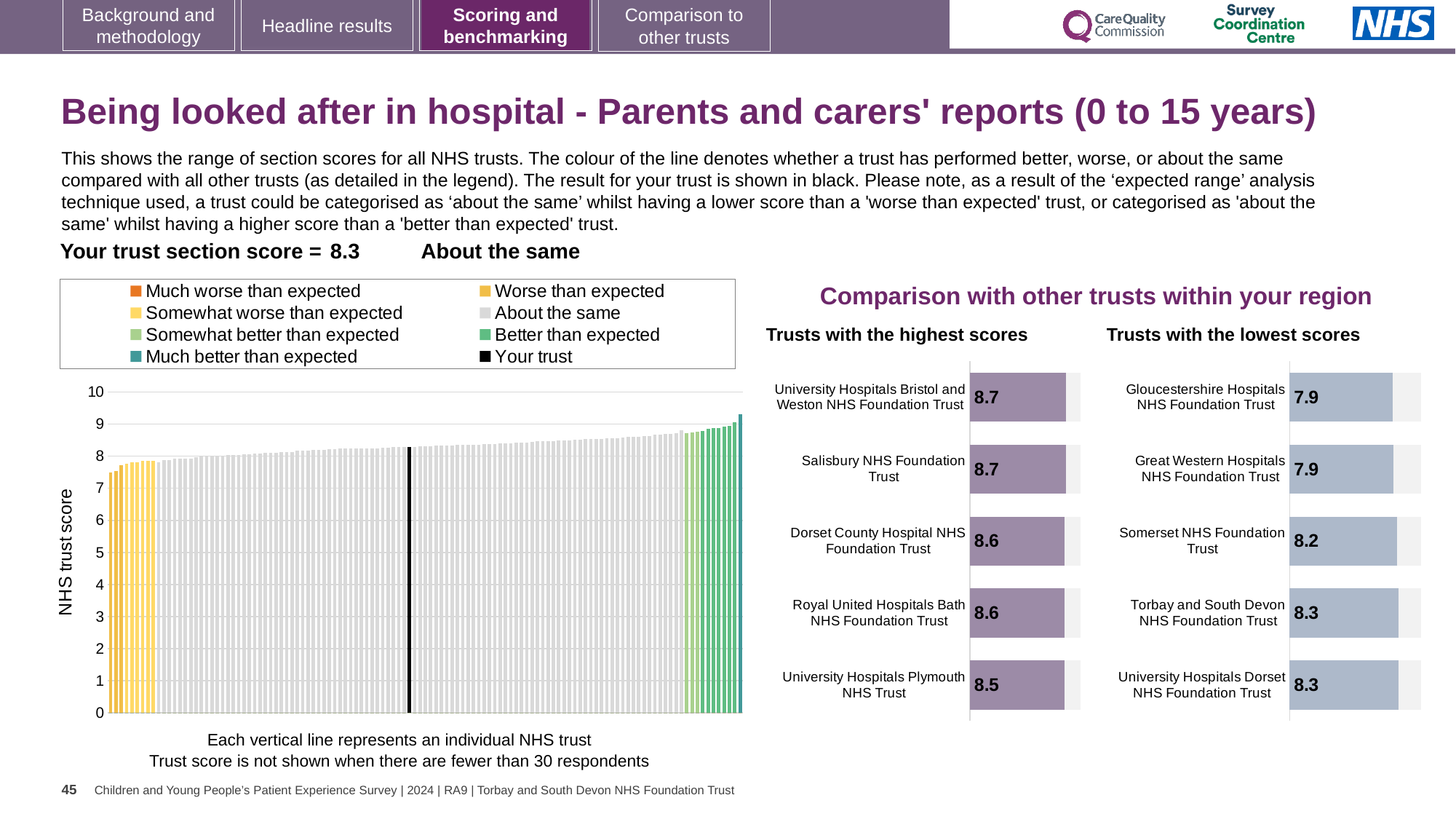
In the 'Trusts with the highest scores' chart, what is the score for Dorset County Hospital NHS Foundation Trust? 8.6 In the 'Trusts with the highest scores' chart, which trust has the lowest score? University Hospitals Plymouth NHS Trust In the 'Trusts with the lowest scores' chart, what is the score for Gloucestershire Hospitals NHS Foundation Trust? 7.9 In the 'Trusts with the lowest scores' chart, what is the score for Somerset NHS Foundation Trust? 8.2 How many entries does the legend of the large chart on the left list? 8 In the 'Trusts with the lowest scores' chart, which has the larger score: Somerset NHS Foundation Trust or Great Western Hospitals NHS Foundation Trust? Somerset NHS Foundation Trust In the 'Trusts with the highest scores' chart, what is the score for University Hospitals Plymouth NHS Trust? 8.5 In the 'Trusts with the lowest scores' chart, what is the difference between the score for Torbay and South Devon NHS Foundation Trust and the score for Great Western Hospitals NHS Foundation Trust? 0.4 How many trusts are listed in the 'Trusts with the lowest scores' chart? 5 In the large chart on the left, do the trust scores rise or fall from left to right along the x axis? Rise What kind of chart is the large chart on the left with the 'NHS trust score' axis? Bar chart In the 'Trusts with the highest scores' chart, what is the difference between the score for University Hospitals Bristol and Weston NHS Foundation Trust and the score for University Hospitals Plymouth NHS Trust? 0.2